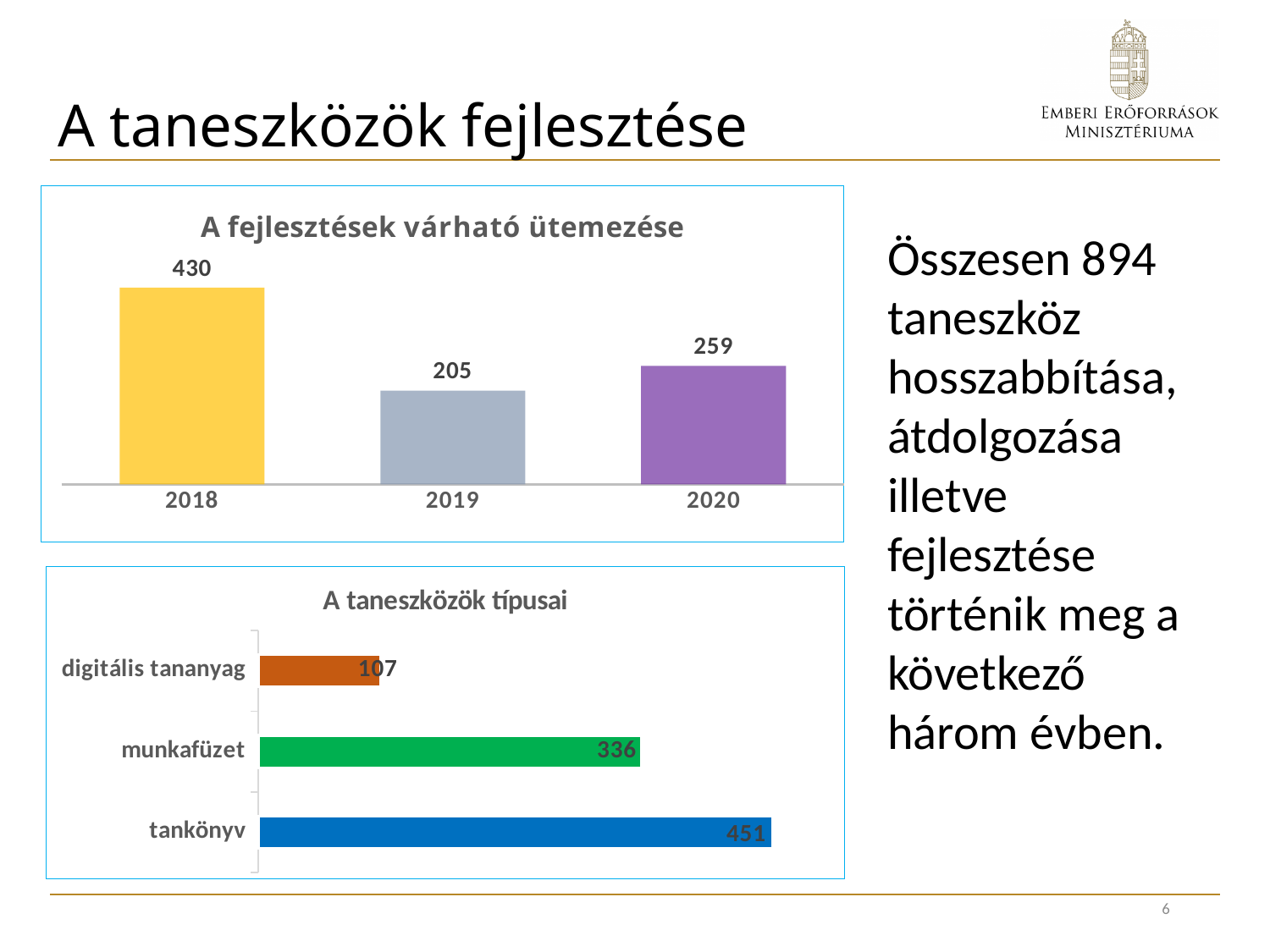
In the chart 'A fejlesztések várható ütemezése', what is the difference between the values for 2018 and 2020? 171 In the chart 'A fejlesztések várható ütemezése', which year has the lowest value? 2019 In the chart 'A fejlesztések várható ütemezése', which year has the highest value? 2018 In the chart 'A fejlesztések várható ütemezése', what kind of chart is it? bar chart In the chart 'A fejlesztések várható ütemezése', what is the value for 2019? 205 In the chart 'A fejlesztések várható ütemezése', what is the value for 2018? 430 In the chart 'A taneszközök típusai', which is larger, munkafüzet or tankönyv? tankönyv In the chart 'A taneszközök típusai', which category has the lowest value? digitális tananyag In the chart 'A fejlesztések várható ütemezése', how many years are shown? 3 In the chart 'A taneszközök típusai', what is the value for tankönyv? 451 In the chart 'A taneszközök típusai', what is the difference between tankönyv and digitális tananyag? 344 In the chart 'A taneszközök típusai', what is the value for munkafüzet? 336